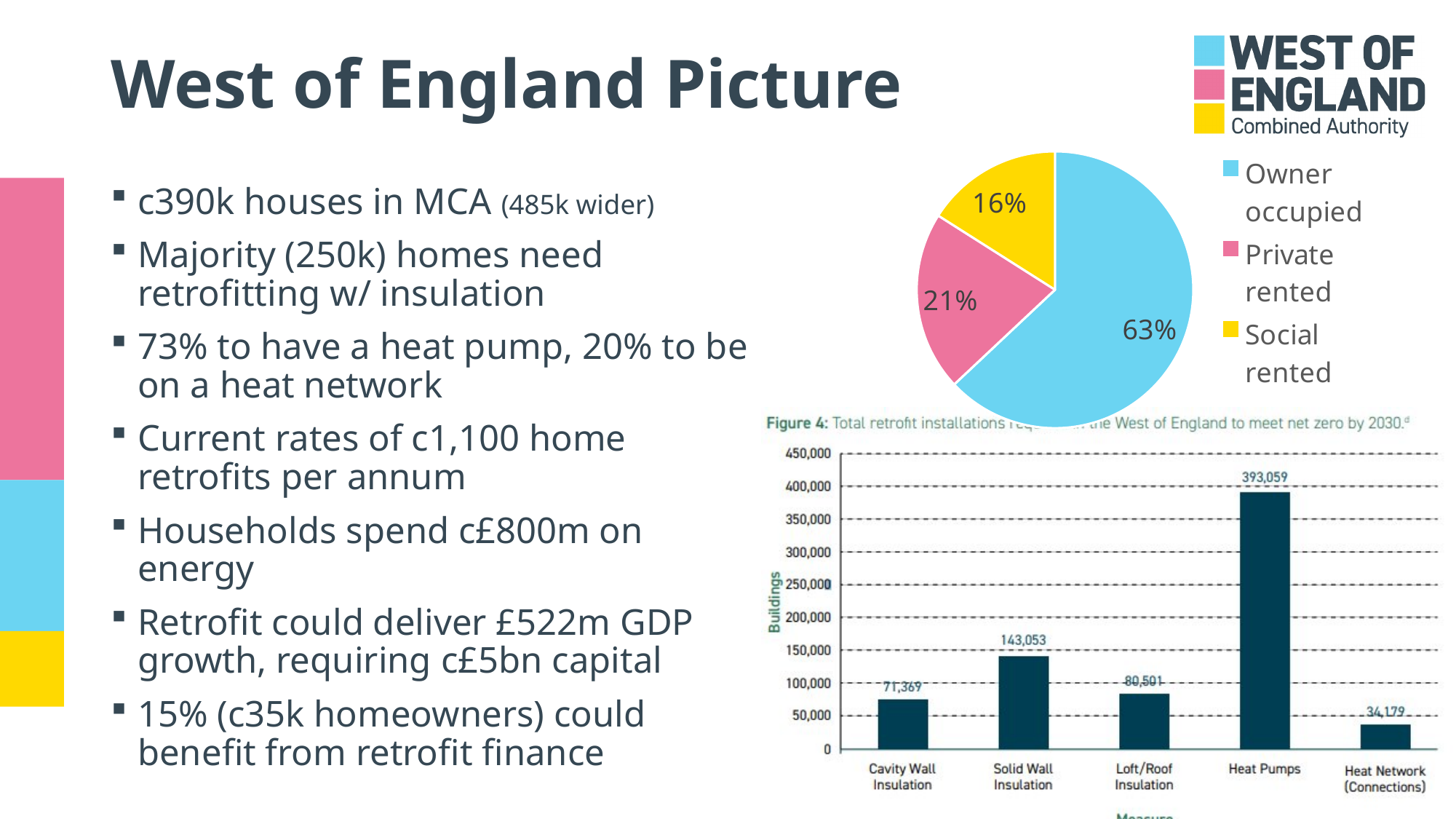
In the pie chart, how many categories does the legend list? 3 In the Figure 4 bar chart, which measure has the highest number of buildings? Heat Pumps In the Figure 4 bar chart, what is the difference between Solid Wall Insulation and Cavity Wall Insulation? 71,684 In the Figure 4 bar chart, what is the value for Solid Wall Insulation? 143,053 In the pie chart, which tenure category has the smallest share? Social rented In the Figure 4 bar chart, what is the value for Heat Pumps? 393,059 In the pie chart, what share is Owner occupied? 63% What kind of chart is Figure 4? Bar chart In the pie chart, what is the difference between the Owner occupied and Private rented shares? 42% In the Figure 4 bar chart, how many measures are shown on the x axis? 5 In the Figure 4 bar chart, which measure has the lowest number of buildings? Heat Network (Connections) In the pie chart, what share is Social rented? 16%